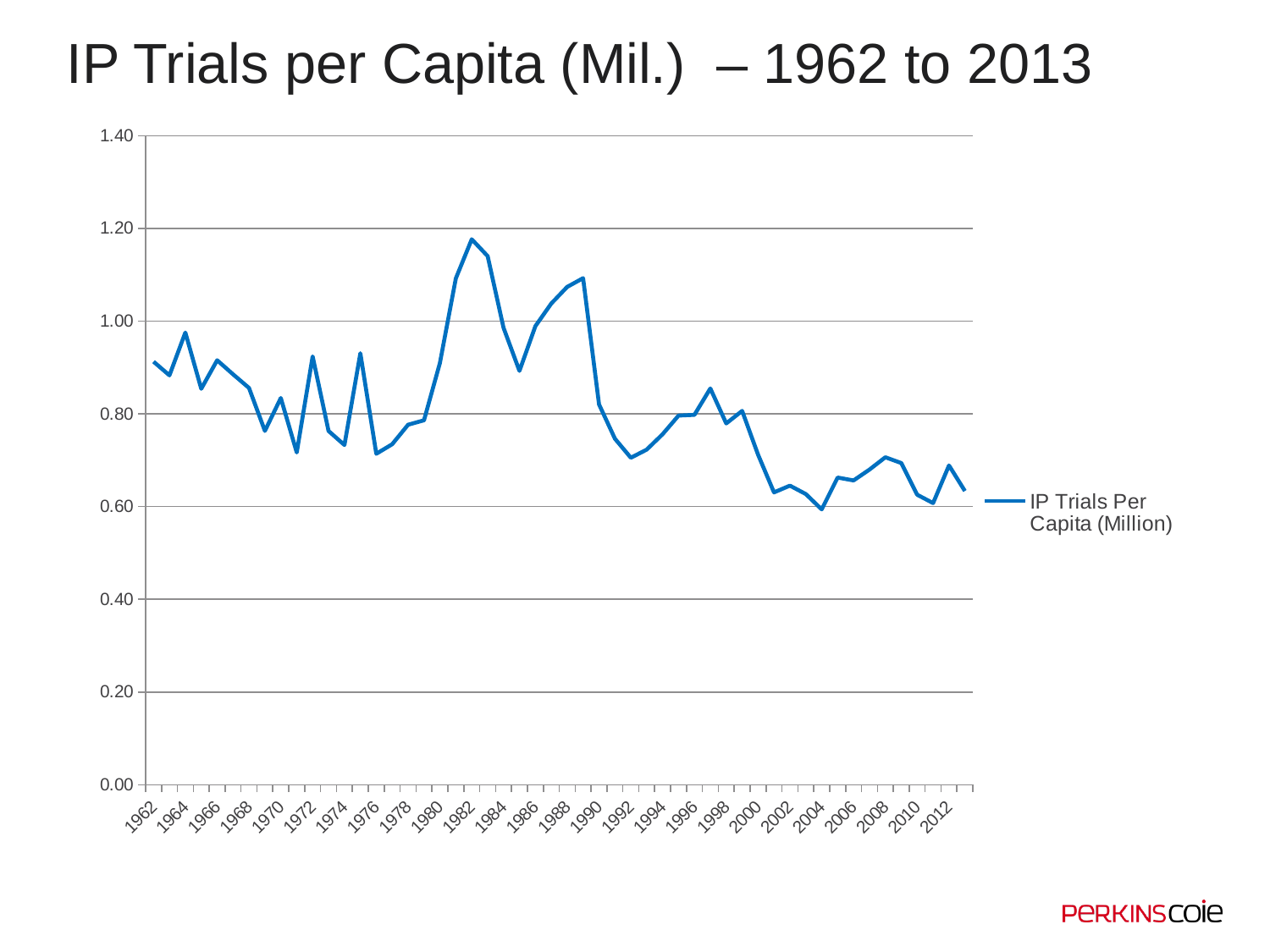
Is the value for 1962 greater or less than 0.80? greater Is the value for 1982 greater or less than 1.00? greater Which year has the larger value, 1989 or 1990? 1989 Is the value for 2004 greater or less than 0.80? less How many series does the legend list? 1 What kind of chart is shown on the slide? line chart Do the values generally rise or fall from 1990 to 2013? fall In which year does the line reach its highest value? 1982 What is the legend entry for the plotted series? IP Trials Per Capita (Million) Which year has the larger value, 1962 or 2013? 1962 What is the title of the chart? IP Trials per Capita (Mil.) – 1962 to 2013